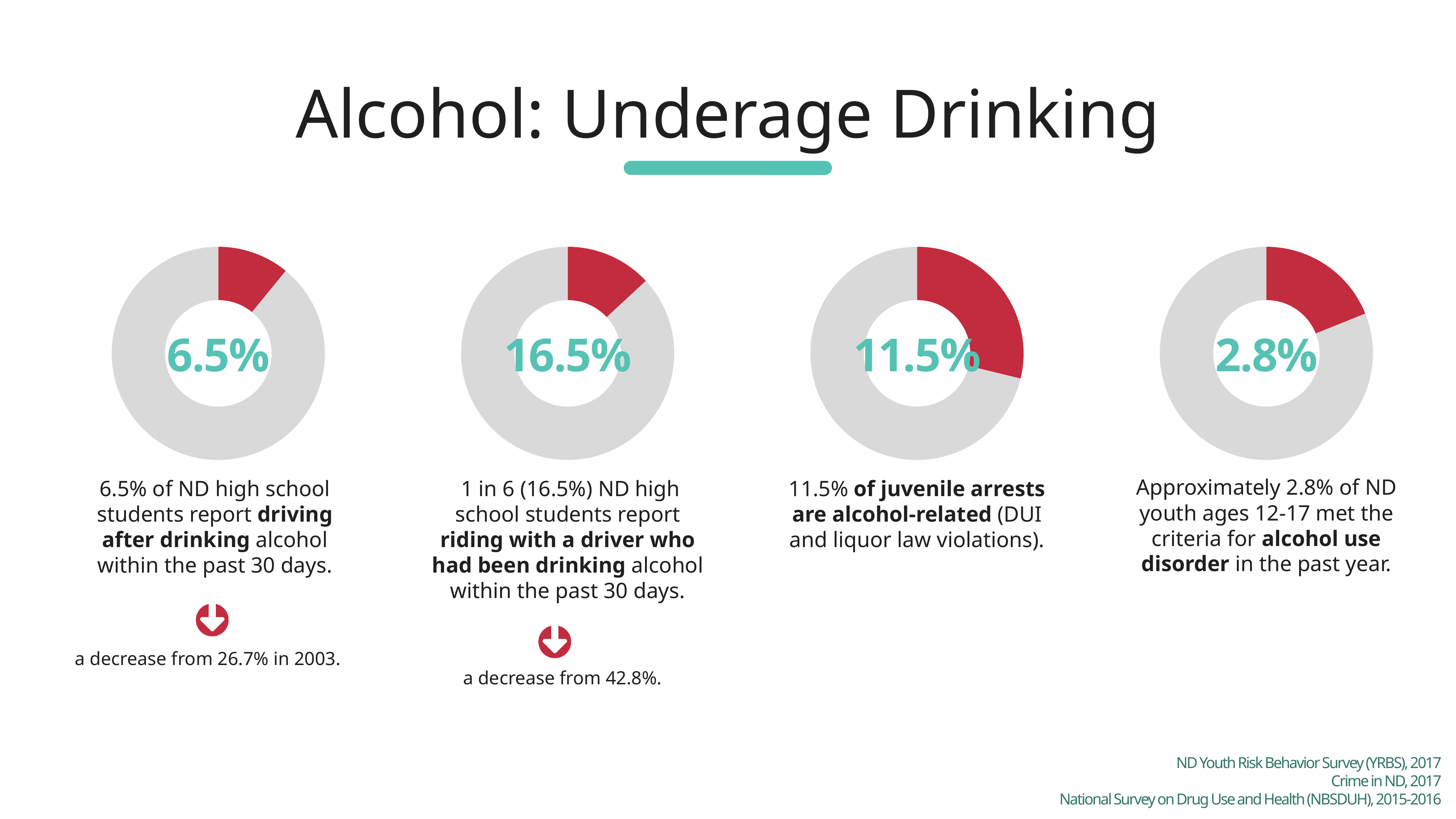
Which of the four donut charts shows the lowest percentage? Alcohol use disorder (2.8%) What percentage is shown in the second donut chart (riding with a driver who had been drinking)? 16.5% What percentage is shown in the rightmost donut chart (alcohol use disorder among ND youth ages 12-17)? 2.8% Which is larger: the percentage of students driving after drinking or the percentage of juvenile arrests that are alcohol-related? Juvenile arrests that are alcohol-related (11.5%) According to the note under the first donut chart, what was the percentage of students driving after drinking in 2003? 26.7% How many donut charts are on the slide? 4 What percentage of juvenile arrests are alcohol-related, according to the third donut chart? 11.5% What kind of chart is used to display each statistic on the slide? Pie (donut) chart Which of the four donut charts shows the highest percentage? Riding with a driver who had been drinking (16.5%) What percentage is shown in the leftmost donut chart (driving after drinking alcohol)? 6.5% What is the difference between the percentage for riding with a drinking driver (16.5%) and driving after drinking (6.5%)? 10% What colour is used for the highlighted slice in each donut chart? Red